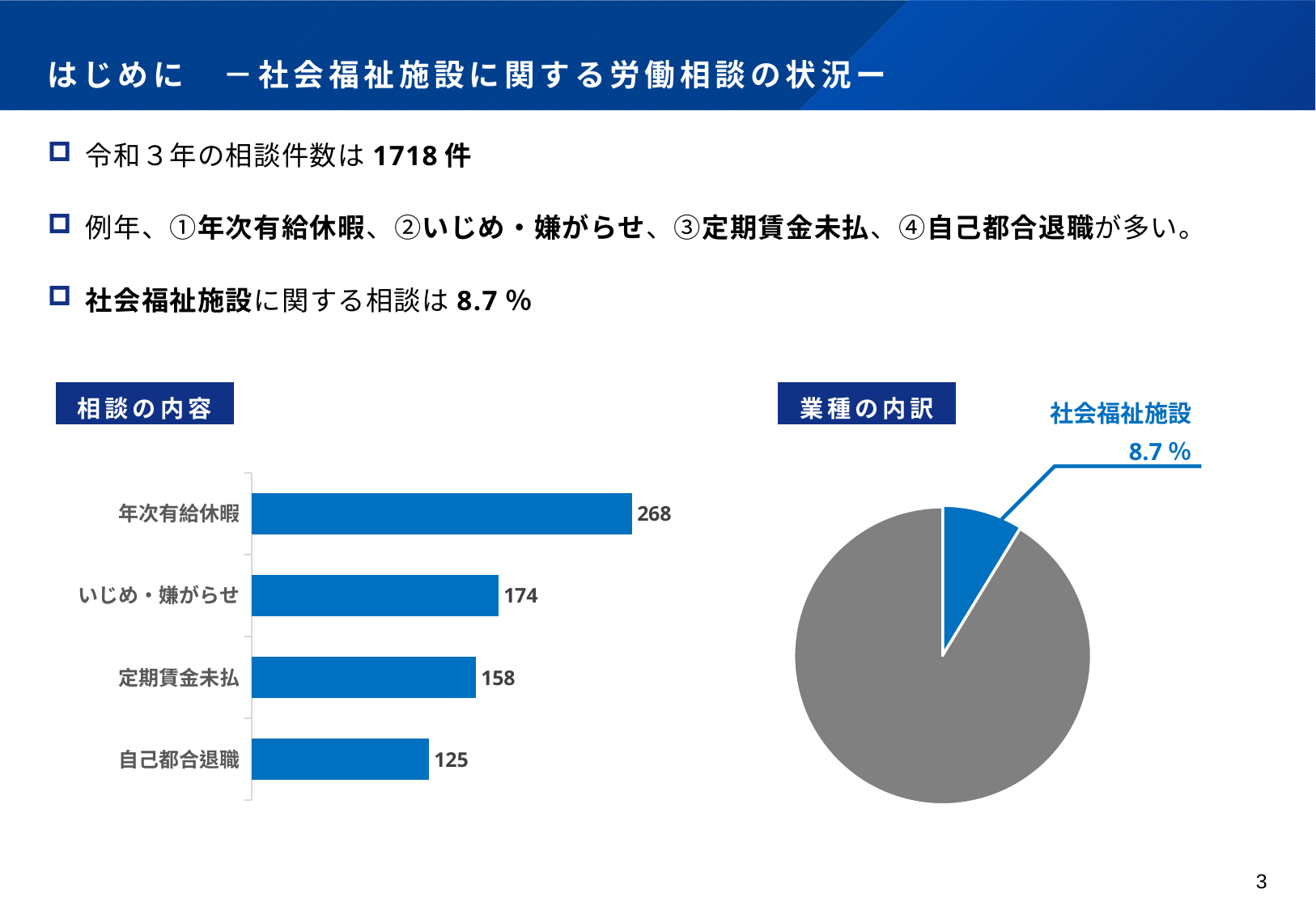
What kind of chart is the 業種の内訳 chart? Pie chart In the 相談の内容 bar chart, which is larger, the value for 定期賃金未払 or 自己都合退職? 定期賃金未払 In the 相談の内容 bar chart, which category has the highest value? 年次有給休暇 What kind of chart is the 相談の内容 chart? Bar chart In the 相談の内容 bar chart, what is the value for 年次有給休暇? 268 In the 相談の内容 bar chart, what is the value for いじめ・嫌がらせ? 174 In the 業種の内訳 pie chart, what share does 社会福祉施設 account for? 8.7 % In the 相談の内容 bar chart, which category has the lowest value? 自己都合退職 In the 相談の内容 bar chart, what is the value for 定期賃金未払? 158 How many categories are shown in the 相談の内容 bar chart? 4 In the 相談の内容 bar chart, what is the value for 自己都合退職? 125 In the 相談の内容 bar chart, what is the difference between the values for 年次有給休暇 and いじめ・嫌がらせ? 94